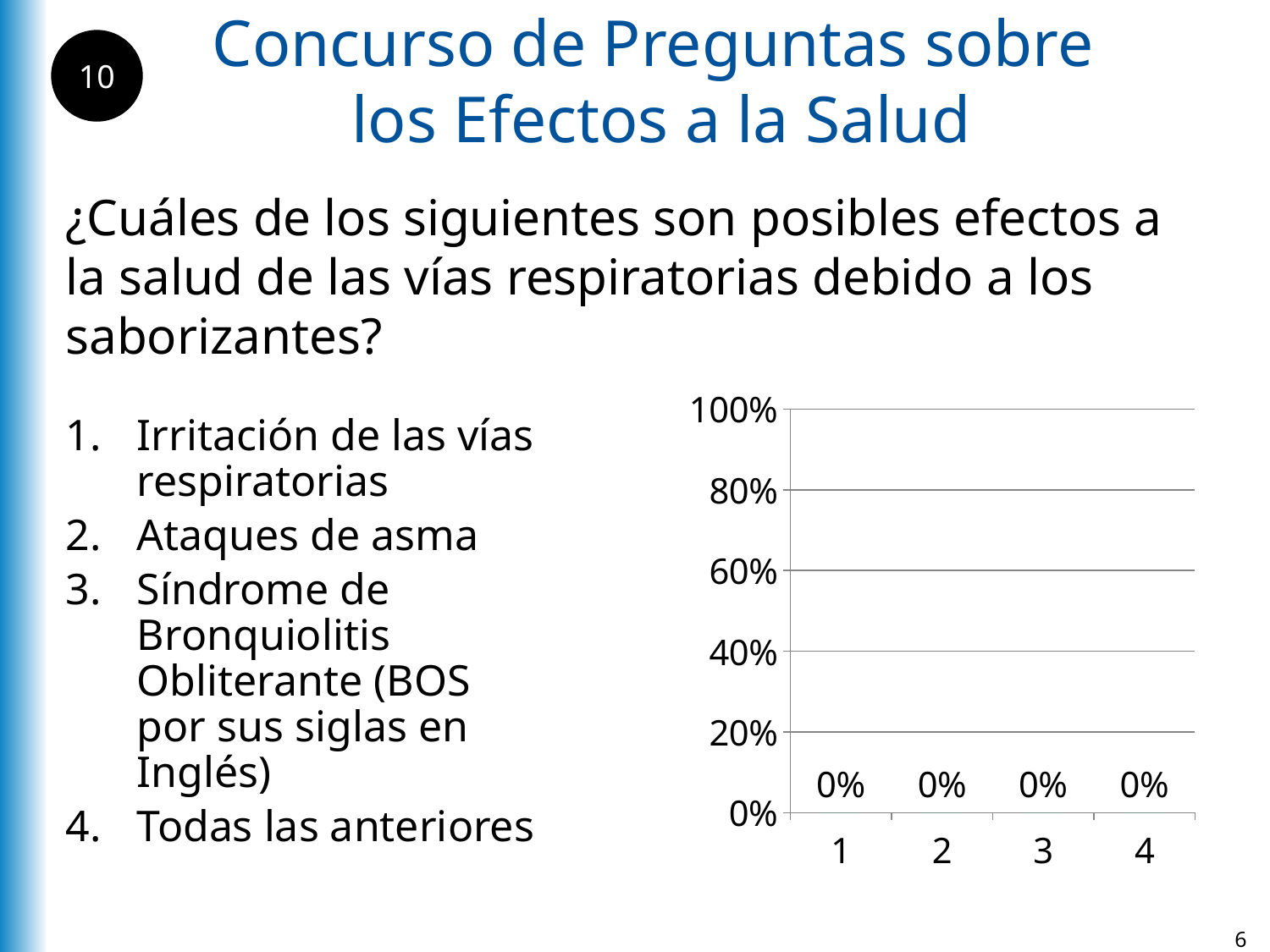
What is the value shown for category 2? 0% How many categories are plotted on the x axis of the chart? 4 What is the difference between the values for category 1 and category 4? 0% What is the lowest tick value shown on the chart's y axis? 0% What is the value shown for category 1? 0% What is the highest tick value shown on the chart's y axis? 100% What is the value shown for category 3? 0% Is the value for category 2 greater or less than 20%? less What is the value shown for category 4? 0% What kind of chart is shown on the slide? bar chart Do the values rise, fall, or stay flat from category 1 to category 4? stay flat